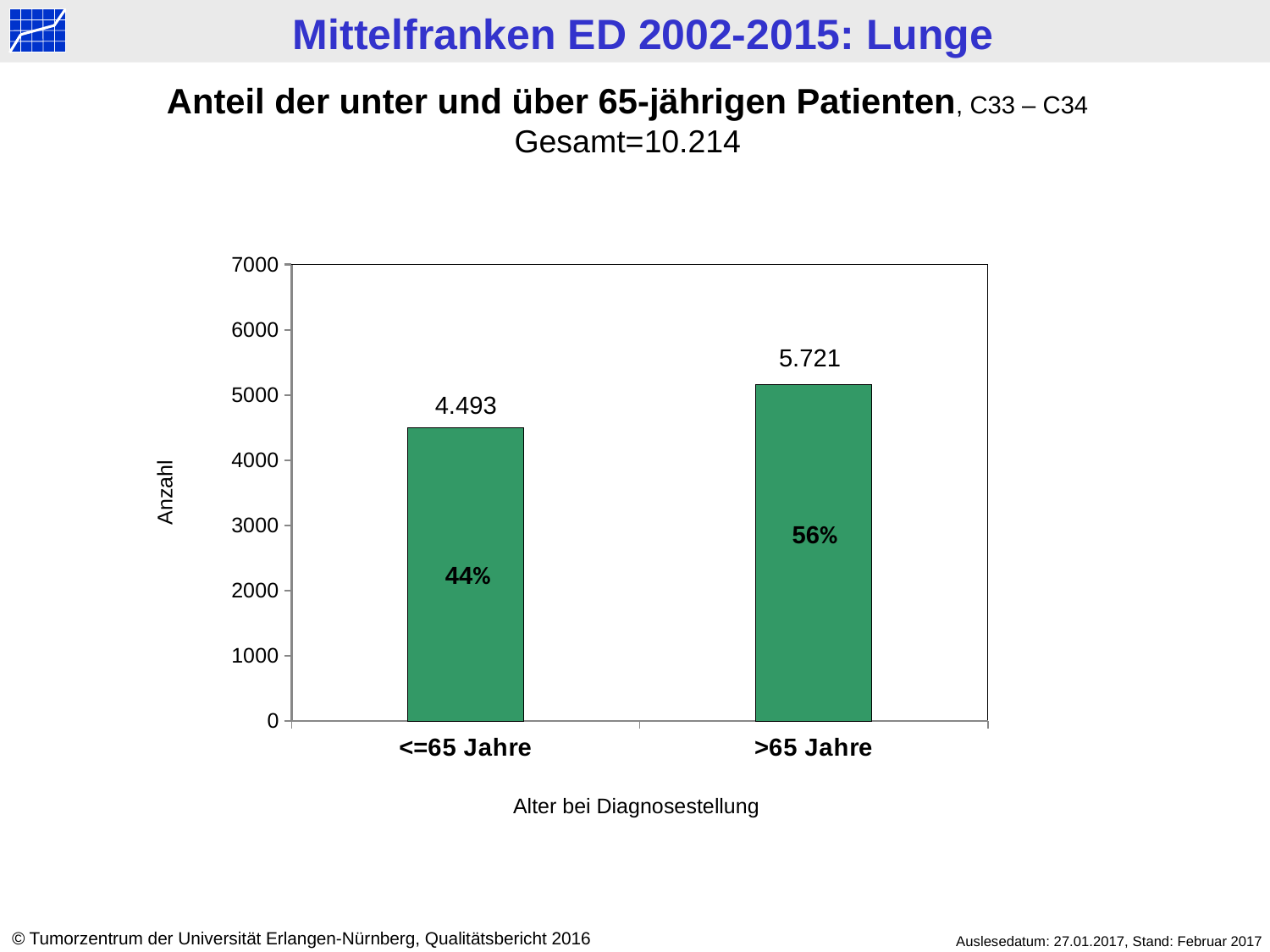
What percentage is shown on the <=65 Jahre bar? 44% What percentage is shown on the >65 Jahre bar? 56% What is the label of the y axis? Anzahl Is the value for <=65 Jahre greater or less than 5000? less What is the value for the <=65 Jahre category? 4.493 Which category has the highest value? >65 Jahre What kind of chart is shown on the slide? bar chart How many categories are shown on the x axis? 2 Which category has the lowest value? <=65 Jahre What is the difference between the values for >65 Jahre and <=65 Jahre? 1.228 What is the value for the >65 Jahre category? 5.721 Which is larger, the value for <=65 Jahre or for >65 Jahre? >65 Jahre